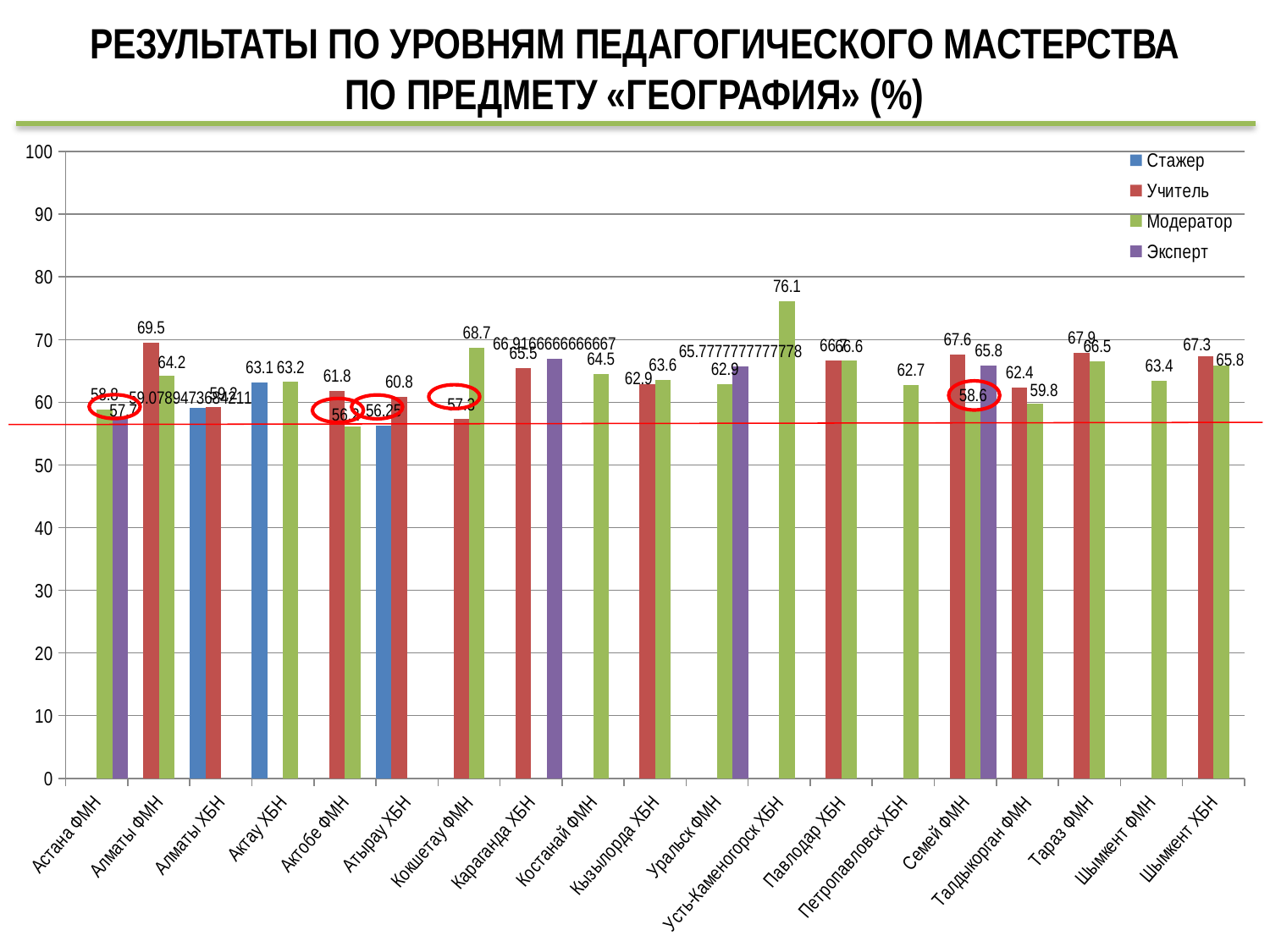
How many series does the legend list? 4 Is the Стажер value for Актау ХБН greater or less than 60? greater What is the Учитель value for Алматы ФМН? 69.5 What kind of chart is shown on the slide? bar chart How many categories are shown along the x axis? 19 For Тараз ФМН, which is larger: the Учитель value or the Модератор value? Учитель What is the Эксперт value for Астана ФМН? 57.7 Which series are listed in the legend? Стажер, Учитель, Модератор, Эксперт What is the Стажер value for Атырау ХБН? 56.25 What is the difference between the Модератор and Учитель values for Кокшетау ФМН? 11.4 What is the Модератор value for Усть-Каменогорск ХБН? 76.1 Which category has the highest Модератор value? Усть-Каменогорск ХБН